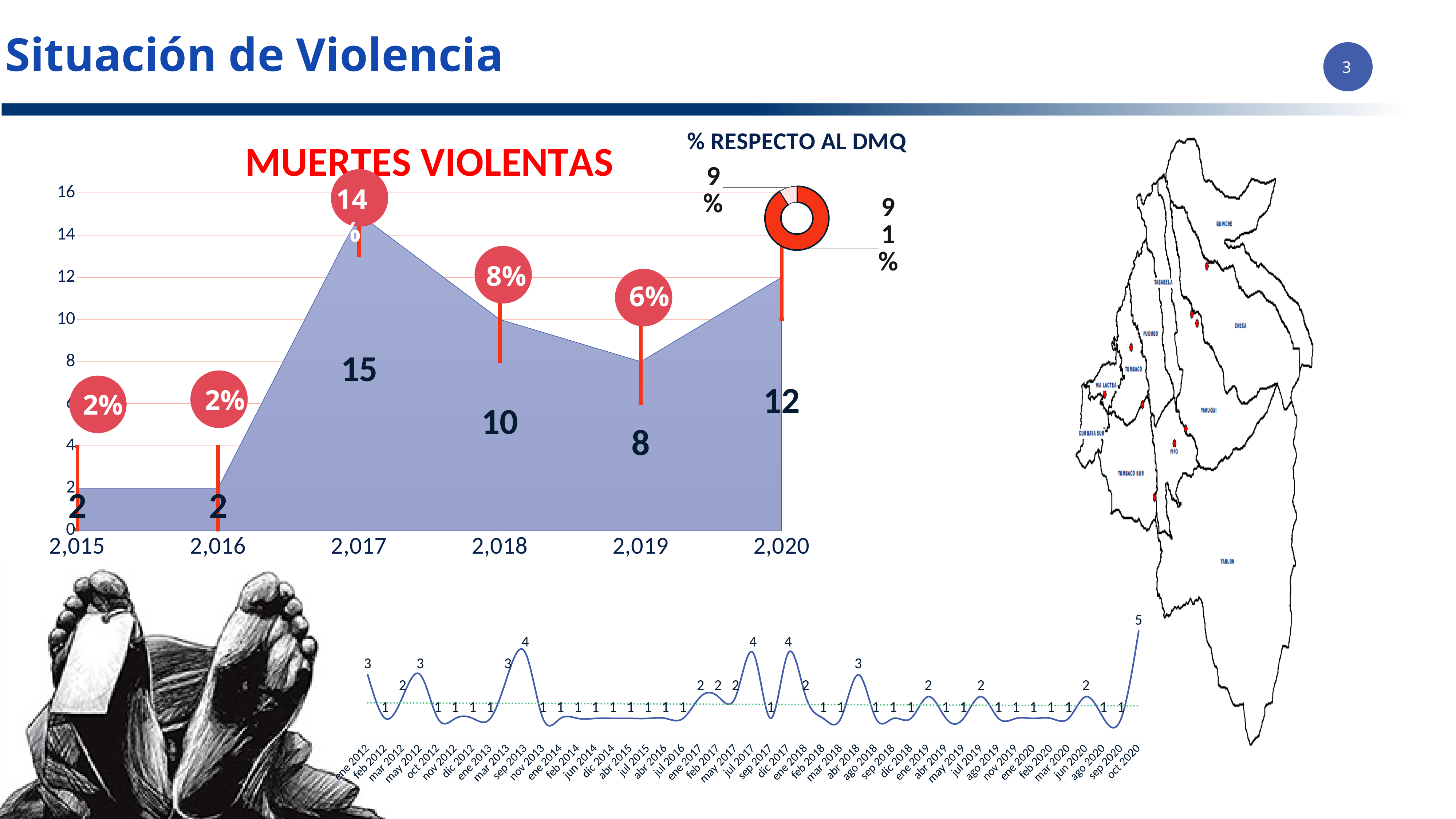
In the MUERTES VIOLENTAS chart, what is the value for 2,020? 12 What kind of chart is the MUERTES VIOLENTAS chart? area chart In the MUERTES VIOLENTAS chart, do the values rise or fall from 2,017 to 2,019? fall In the MUERTES VIOLENTAS chart, which year has the highest value? 2,017 In the monthly line chart at the bottom of the slide, which month has the highest value? oct 2020 In the monthly line chart at the bottom of the slide, what is the value for sep 2013? 4 In the MUERTES VIOLENTAS chart, what is the difference between the values for 2,017 and 2,018? 5 In the MUERTES VIOLENTAS chart, which is larger, the value for 2,019 or the value for 2,020? 2,020 In the MUERTES VIOLENTAS chart, what percentage label is shown above 2,018? 8% In the MUERTES VIOLENTAS chart, what is the value for 2,017? 15 In the % RESPECTO AL DMQ donut chart, what share does the larger slice represent? 91% In the MUERTES VIOLENTAS chart, how many years are plotted on the x axis? 6